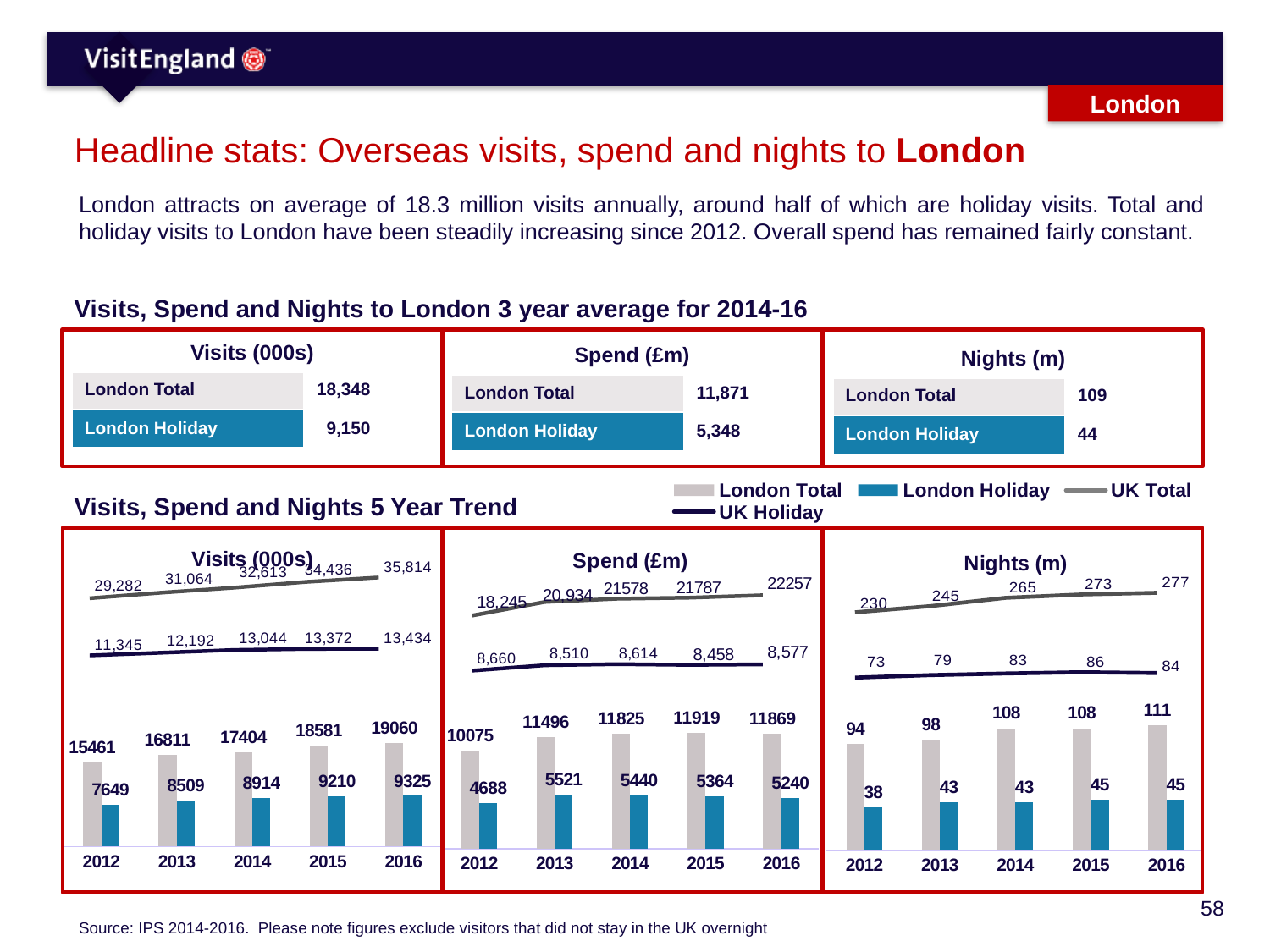
In the Spend (£m) chart, which year has the highest London Total value? 2015 In the Visits (000s) chart, which year has the lowest London Holiday value? 2012 In the Visits (000s) chart, does the London Total value rise or fall from 2012 to 2016? rise In the Spend (£m) chart, what is the UK Total value for 2012? 18,245 How many years are shown on the x axis of the Visits (000s) chart? 5 How many series does the legend above the 5 Year Trend charts list? 4 In the Nights (m) chart, what is the difference between London Total and London Holiday in 2016? 66 In the Spend (£m) chart, what is the London Holiday value for 2013? 5521 In the Spend (£m) chart, is the UK Holiday value for 2012 larger or smaller than the UK Holiday value for 2016? larger In the Visits (000s) chart, what is the London Total value for 2016? 19060 In the Nights (m) chart, what is the UK Total value for 2014? 265 What kind of chart is the Nights (m) 5 Year Trend chart? Combined bar and line chart